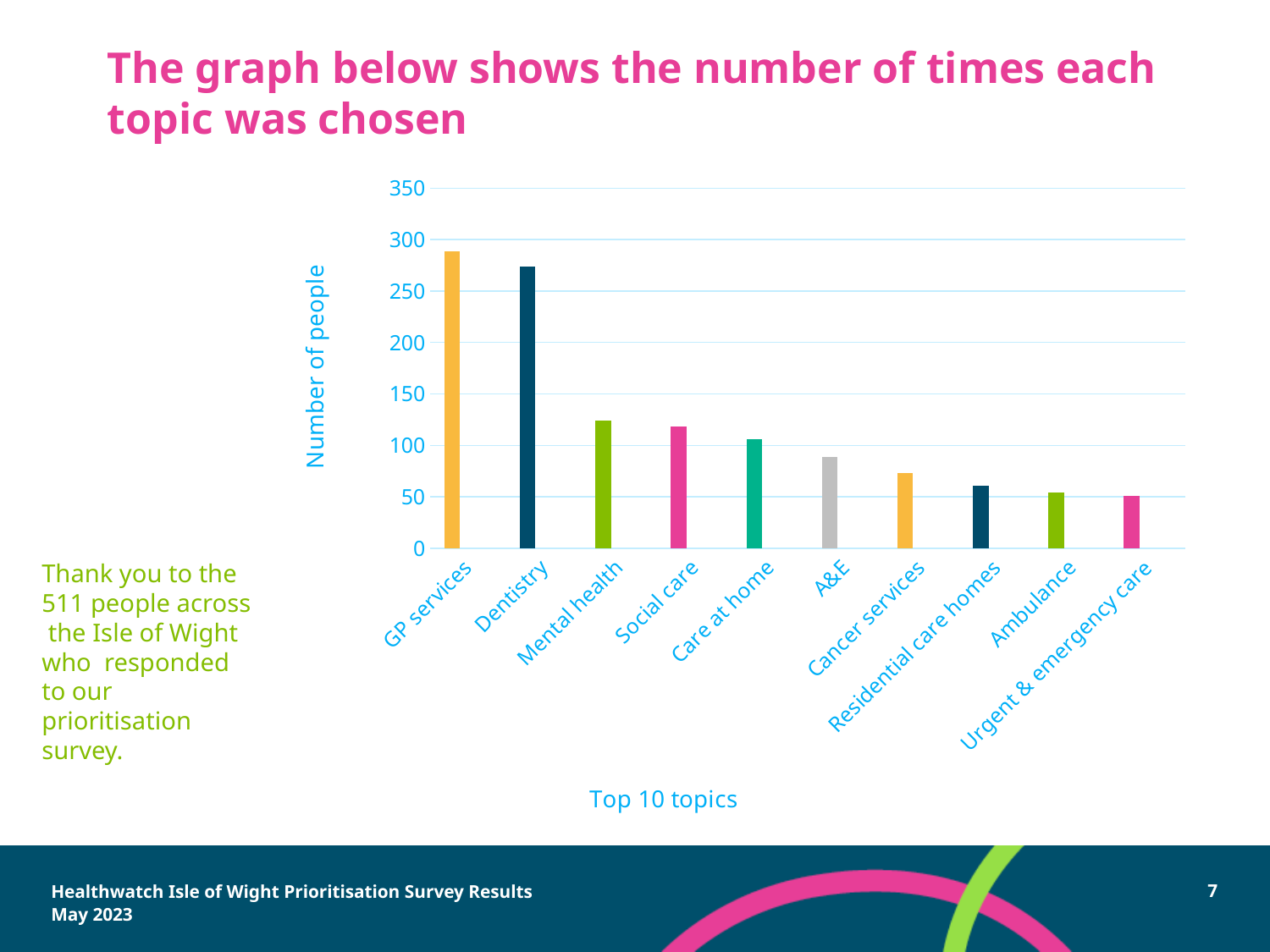
Is the value for GP services greater or less than 250? greater Do the values rise or fall moving from left to right along the x axis? fall What is the title of the horizontal axis? Top 10 topics Is the value for Dentistry greater or less than 300? less Is the value for Mental health greater or less than 100? greater How many topics are plotted on the chart? 10 What is the title of the vertical axis? Number of people What kind of chart is shown on the slide? bar chart Which was chosen more times, Mental health or A&E? Mental health Which topic was chosen the most times? GP services